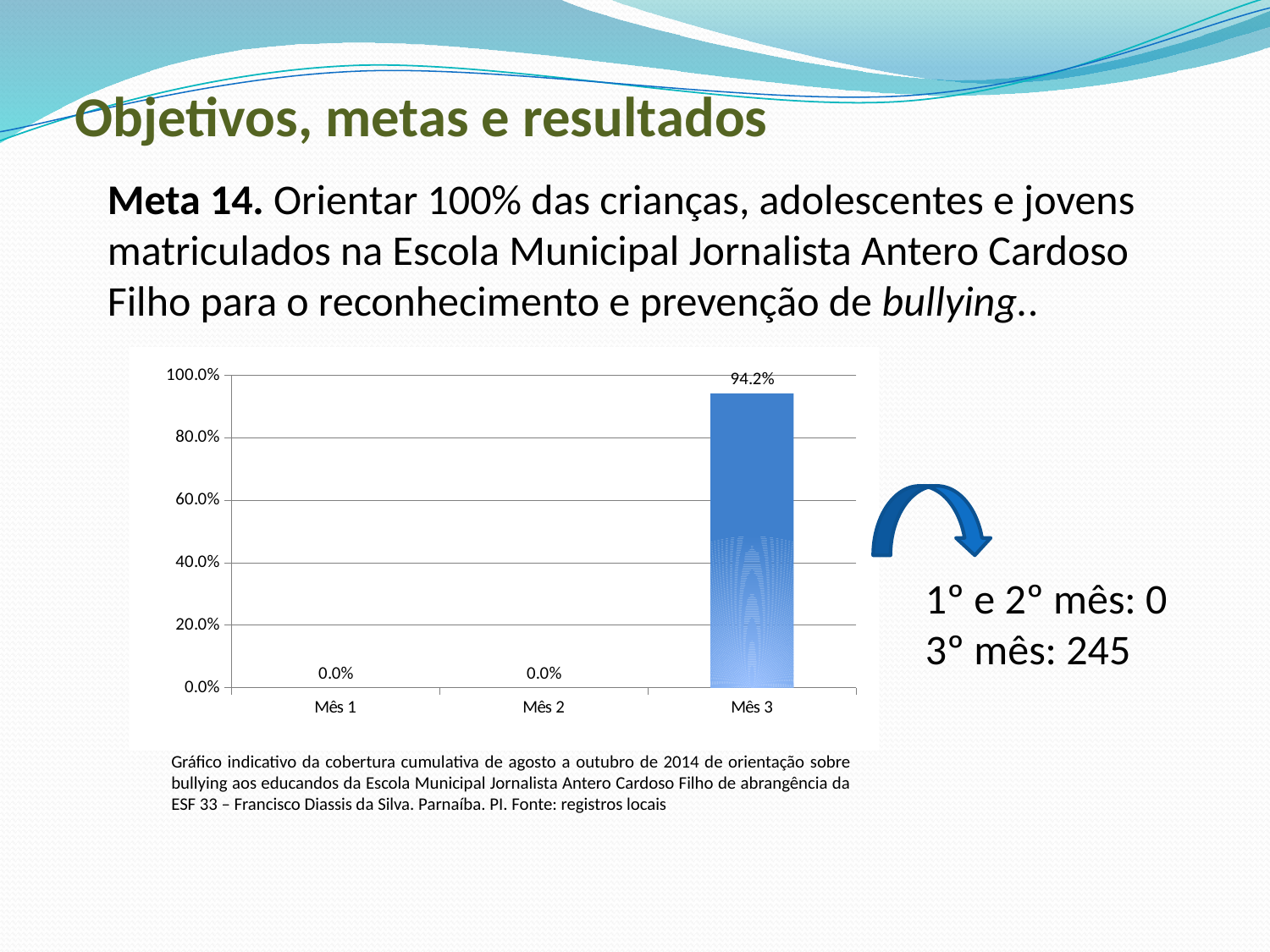
What is the highest value shown on the y axis? 100.0% Which month has the highest value? Mês 3 What kind of chart is shown on the slide? bar chart What is the difference between the values for Mês 3 and Mês 2? 94.2% How many months are shown on the x axis? 3 What is the value for Mês 1? 0.0% What colour is the bar for Mês 3? blue Do the values rise or fall from Mês 1 to Mês 3? rise Which is larger, the value for Mês 1 or the value for Mês 3? Mês 3 What is the value for Mês 3? 94.2% What is the value for Mês 2? 0.0% Is the value for Mês 3 greater or less than 80.0%? greater